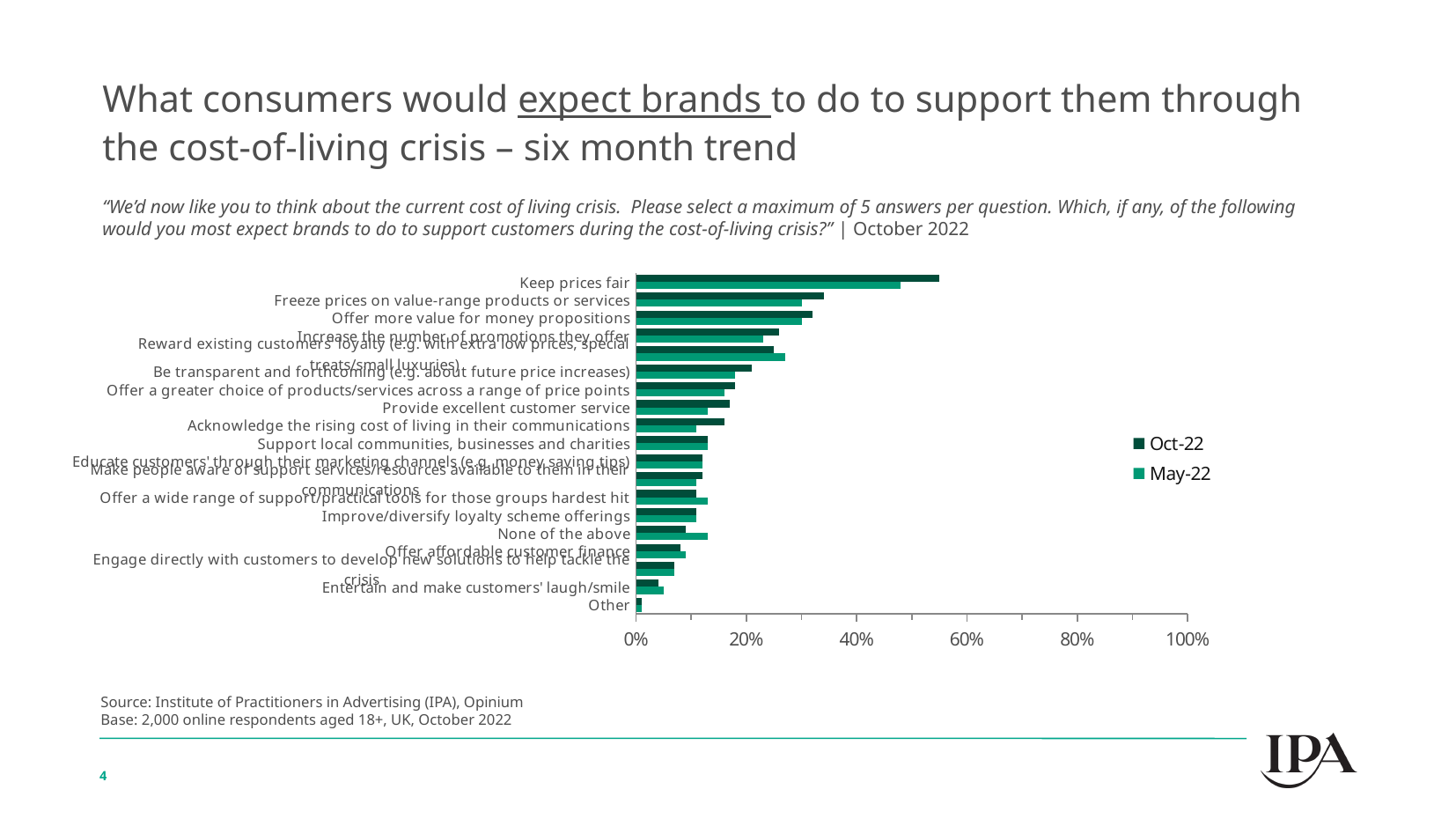
What are the two series named in the legend? Oct-22 and May-22 Is the Oct-22 value for Freeze prices on value-range products or services greater or less than 20%? greater What kind of chart is shown on the slide? bar chart Is the May-22 value for Keep prices fair greater or less than 40%? greater Which category has the lowest value for Oct-22? Other For Oct-22, which is larger: Keep prices fair or Freeze prices on value-range products or services? Keep prices fair Which category has the highest value for Oct-22? Keep prices fair How many series does the legend list? 2 Is the Oct-22 value for Provide excellent customer service greater or less than 20%? less For Keep prices fair, which series has the larger value, Oct-22 or May-22? Oct-22